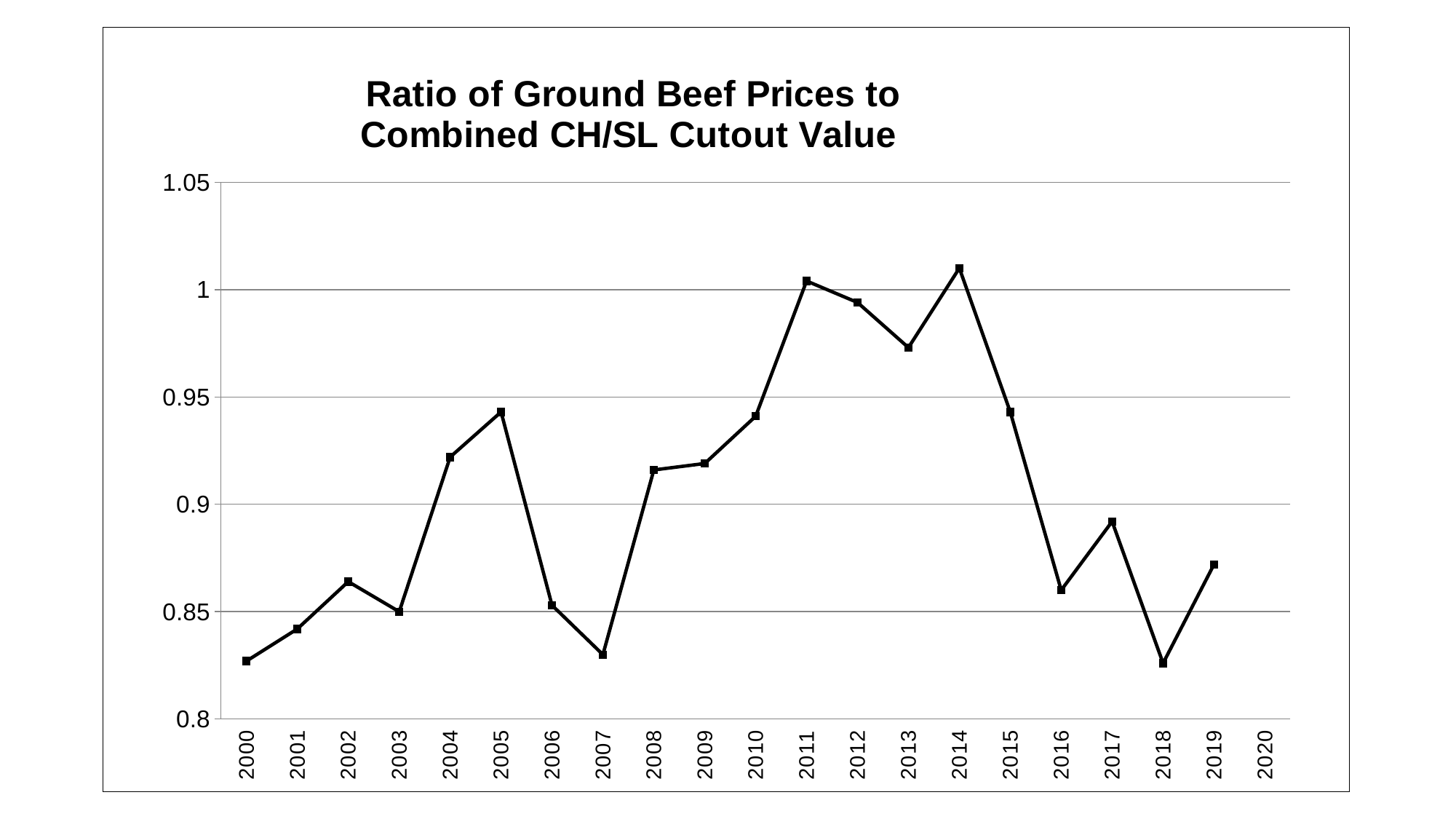
What is the title of the chart? Ratio of Ground Beef Prices to Combined CH/SL Cutout Value Which is larger, the value for 2005 or the value for 2006? 2005 Is the value for 2005 greater or less than 0.9? greater Do the values rise or fall from 2007 to 2011? rise Is the value for 2014 greater or less than 1? greater Is the value for 2007 greater or less than 0.85? less Which is larger, the value for 2013 or the value for 2015? 2013 Which year has the highest ratio? 2014 How many years are labeled on the x axis? 21 What kind of chart is shown on the slide? line chart Do the values rise or fall from 2014 to 2016? fall